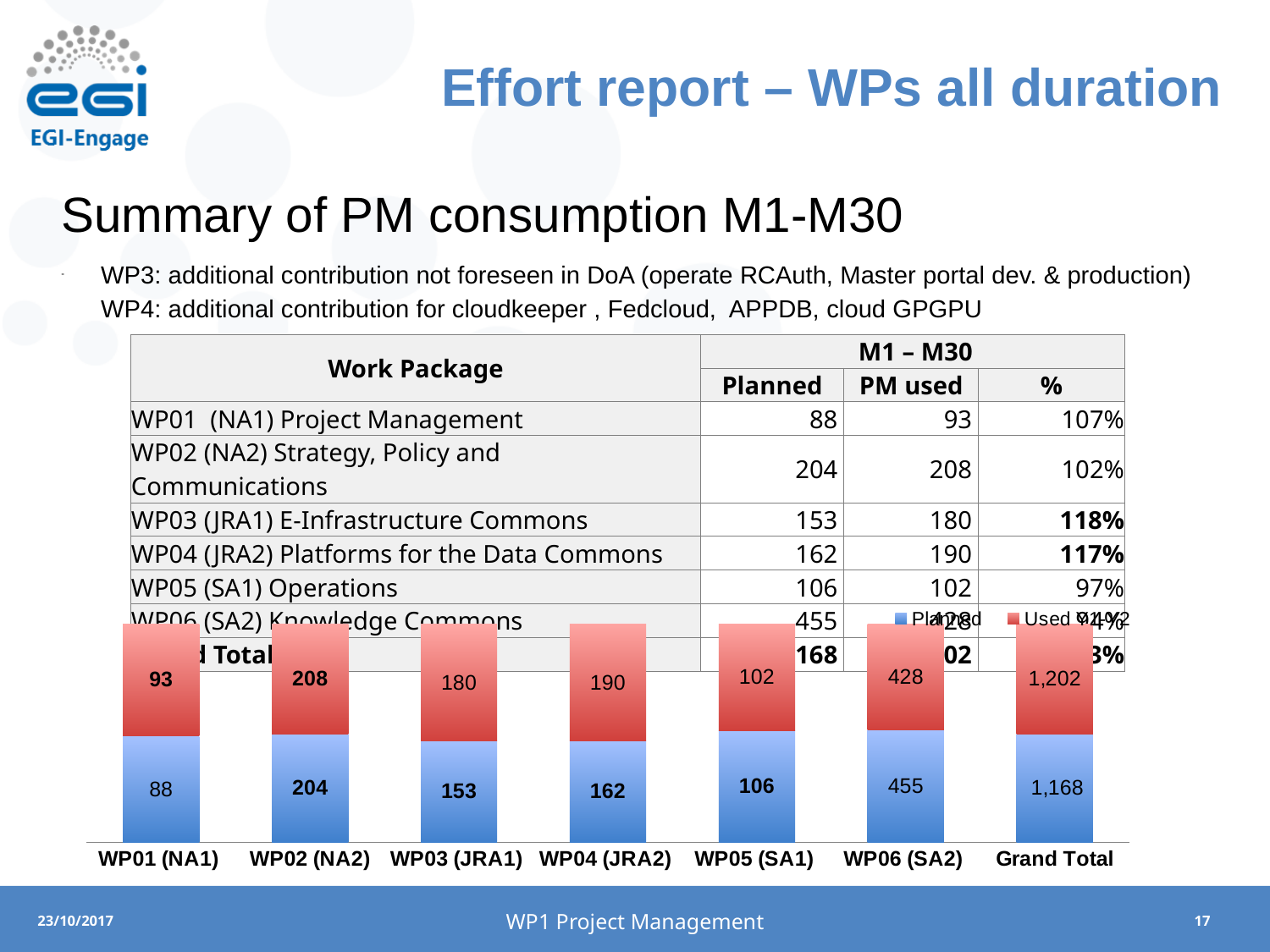
What is the Planned value for the Grand Total bar? 1,168 Which work package has the lowest Planned value in the bar chart? WP01 (NA1) What kind of chart is shown on the slide? stacked bar chart How many categories are shown on the x axis of the bar chart? 7 Is the Used value for WP05 (SA1) larger or smaller than its Planned value? smaller What is the Used value for WP04 (JRA2) in the bar chart? 190 How many series does the bar chart's legend list? 2 What is the Planned value for WP03 (JRA1) in the bar chart? 153 What is the difference between the Used and Planned values for WP03 (JRA1)? 27 Which work package (excluding Grand Total) has the highest Planned value in the bar chart? WP06 (SA2) What is the Used value for WP06 (SA2) in the bar chart? 428 What is the total of the stacked bar for WP01 (NA1)? 181